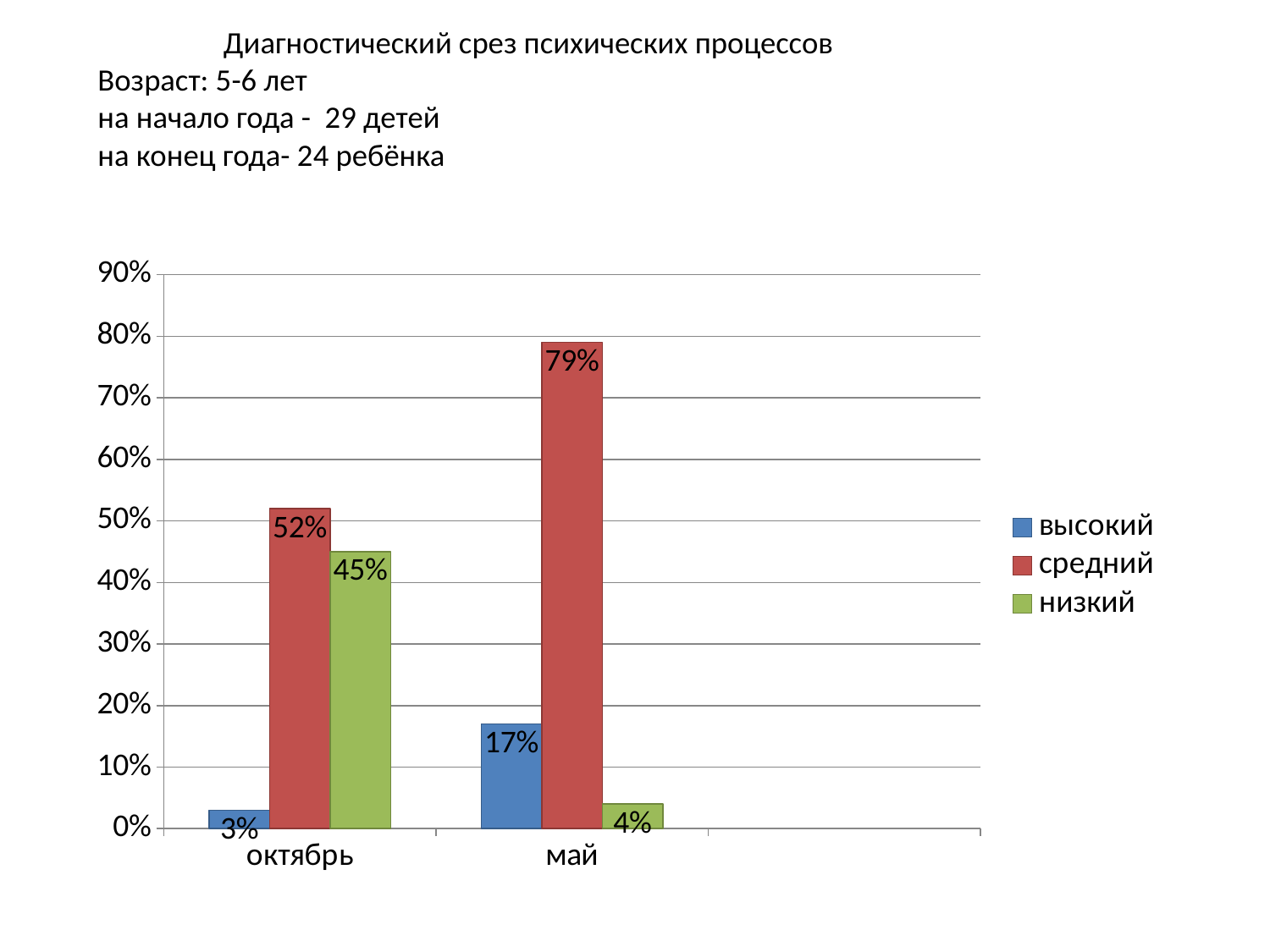
Which series has the highest value in май? средний Which series has the lowest value in октябрь? высокий What is the value for высокий in май? 17% What is the value for низкий in октябрь? 45% What is the value for средний in май? 79% What kind of chart is shown on the slide? bar chart What is the difference between the средний values for май and октябрь? 27% How many categories are shown on the x axis? 2 Which colour represents the средний series? red What is the value for высокий in октябрь? 3% How many series does the legend list? 3 Which is larger: низкий in октябрь or низкий in май? низкий in октябрь